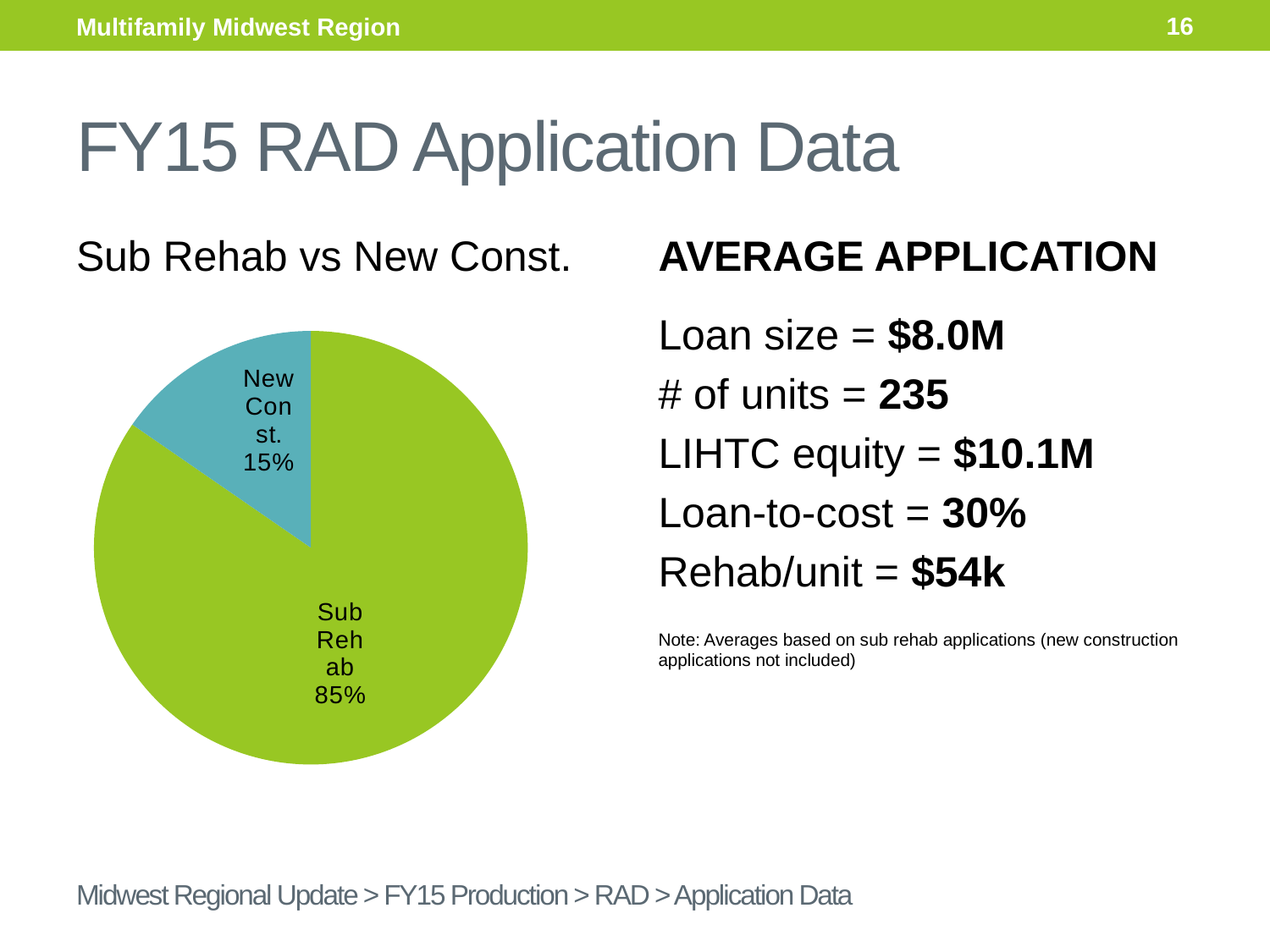
What kind of chart is shown on the slide? pie chart What do the two slices of the pie add up to? 100% What share of the pie does New Const. represent? 15% What colour is the Sub Rehab slice of the pie? green What share of the pie does Sub Rehab represent? 85% How many slices does the pie chart have? 2 What is the title of the pie chart? Sub Rehab vs New Const. Which is larger, the Sub Rehab slice or the New Const. slice? Sub Rehab Which slice of the pie is the smallest? New Const. What is the difference in percentage points between the Sub Rehab and New Const. slices? 70 Which slice of the pie is the largest? Sub Rehab